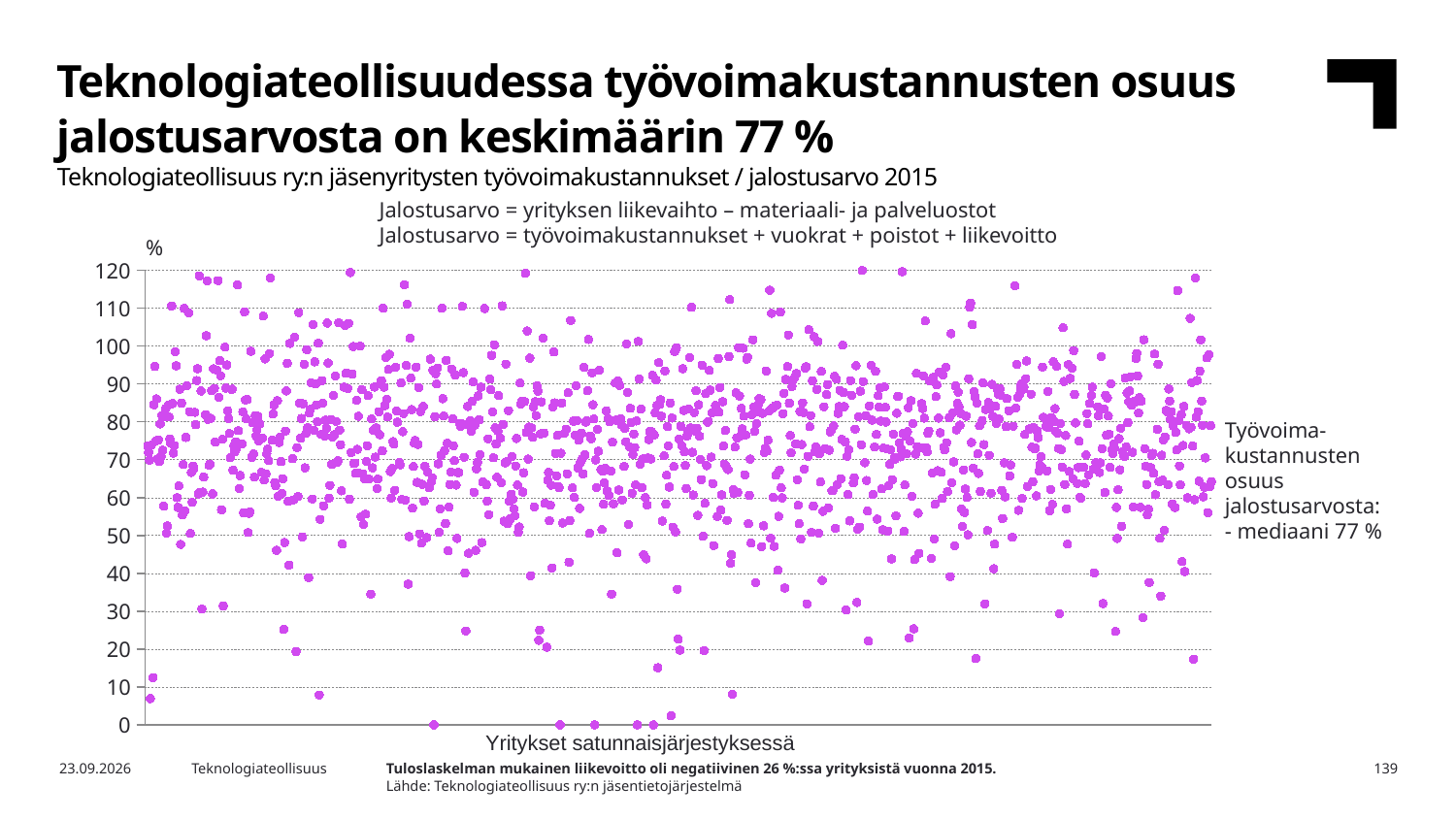
What unit is shown at the top of the y axis of the chart? % According to the footnote below the chart, in what percentage of companies was the operating profit negative in 2015? 26 % What is the label of the x axis of the chart? Yritykset satunnaisjärjestyksessä What kind of chart is shown on the slide? scatter chart According to the annotation on the right of the chart, what is the median share of labour costs in value added (työvoimakustannusten osuus jalostusarvosta)? 77 %